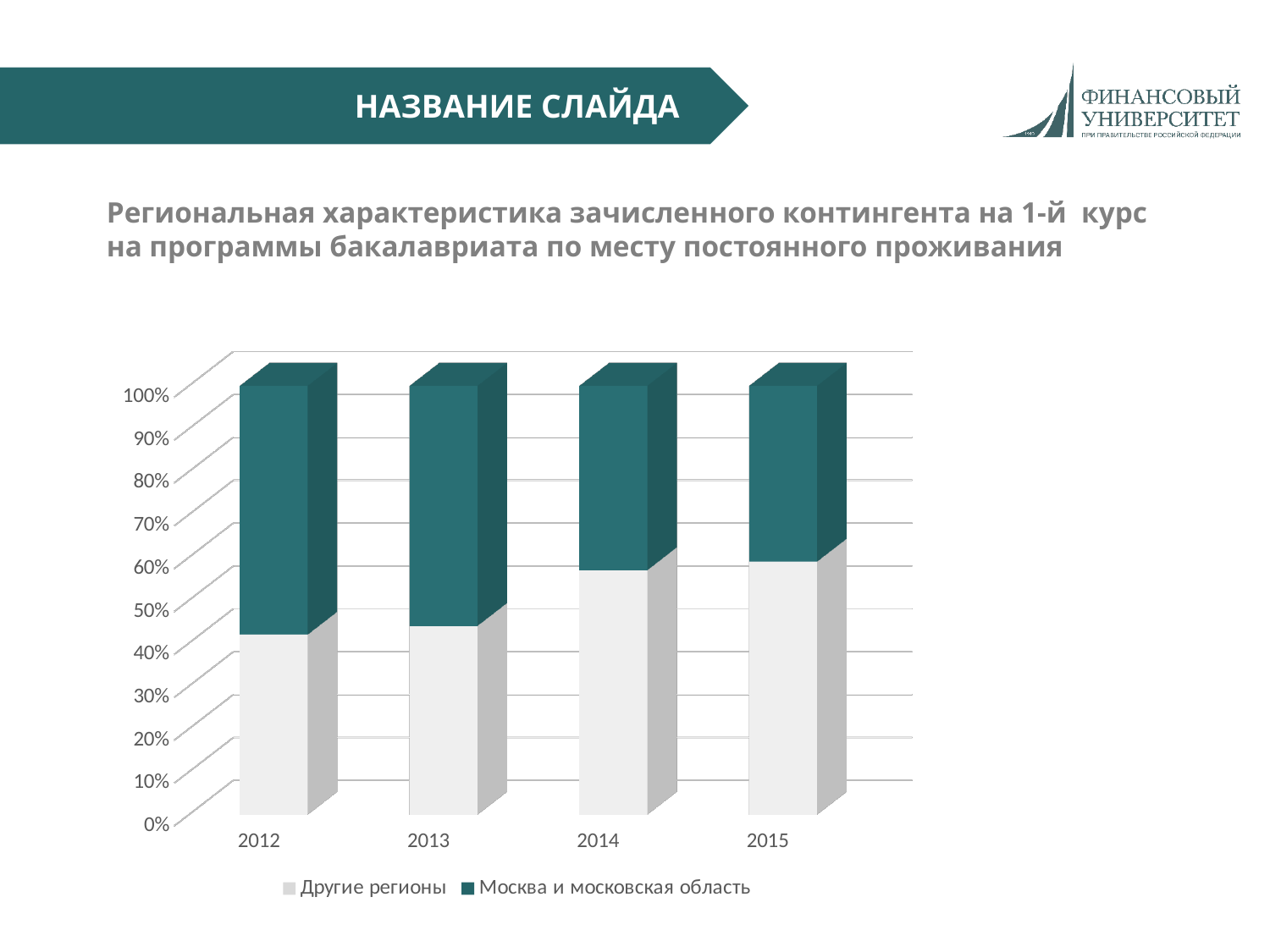
How many series does the chart legend list? 2 Does the share of Другие регионы rise or fall from 2012 to 2015? rise Is the share of Другие регионы in 2015 greater or less than 50%? greater Is the share of Другие регионы in 2012 greater or less than 50%? less Which is larger: the share of Москва и московская область in 2012 or in 2015? 2012 Which is larger: the share of Другие регионы in 2012 or in 2014? 2014 Is the share of Москва и московская область in 2013 greater or less than 50%? greater What kind of chart is shown on the slide? Stacked bar chart Which two series are listed in the chart legend? Другие регионы; Москва и московская область How many years are shown on the x axis of the chart? 4 Which series is shown in the dark teal colour? Москва и московская область